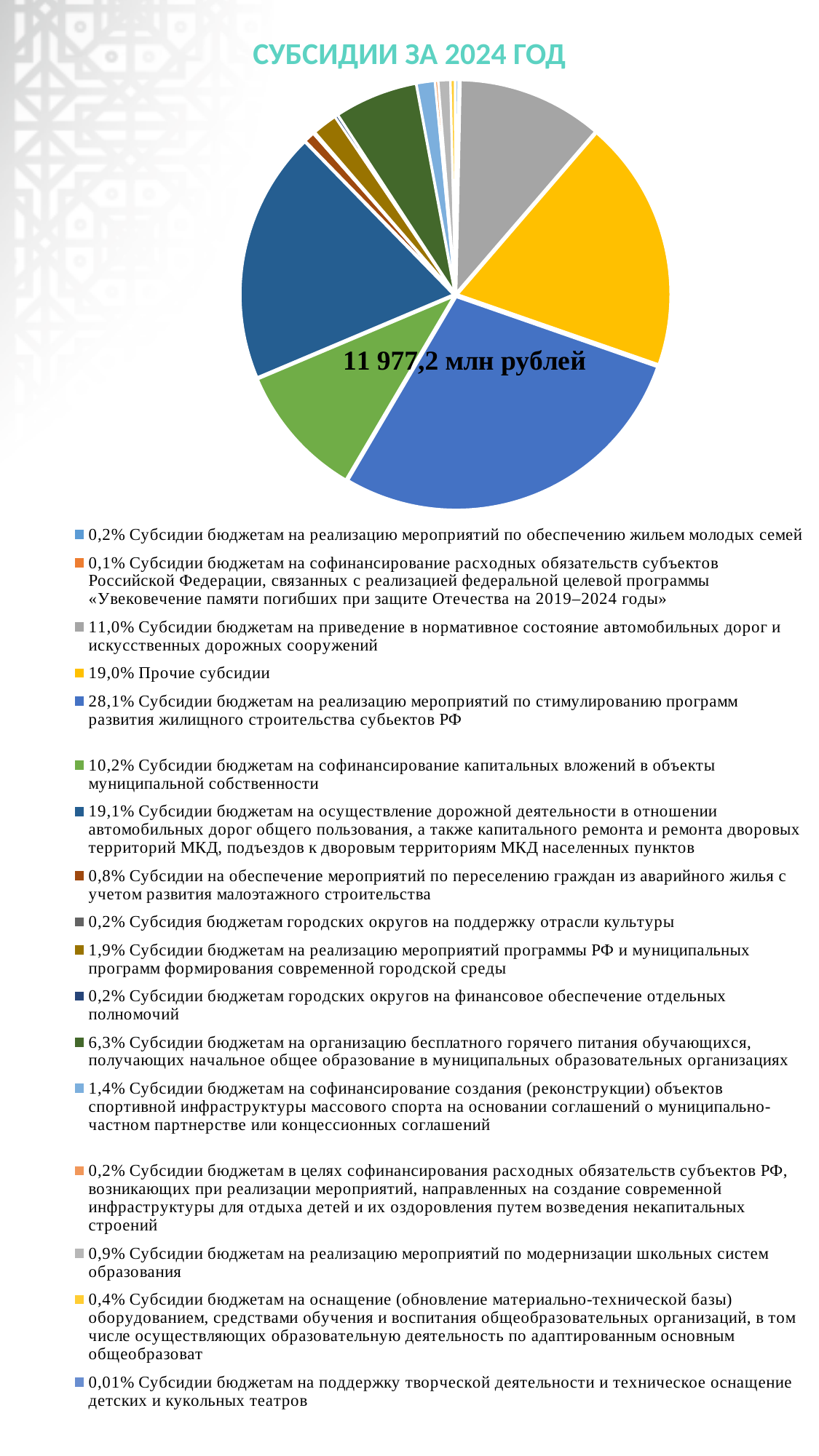
What total amount is printed in the centre of the pie chart? 11 977,2 млн рублей Which category has the largest share of the pie? Субсидии бюджетам на реализацию мероприятий по стимулированию программ развития жилищного строительства субъектов РФ (28,1%) Which category has the smallest share of the pie? Субсидии бюджетам на поддержку творческой деятельности и техническое оснащение детских и кукольных театров (0,01%) What share of the pie is 'Субсидии бюджетам на реализацию мероприятий по модернизации школьных систем образования'? 0,9% Which is larger: the share for 'Субсидии бюджетам на организацию бесплатного горячего питания обучающихся...' or the share for 'Субсидии бюджетам на реализацию мероприятий программы РФ и муниципальных программ формирования современной городской среды'? Субсидии бюджетам на организацию бесплатного горячего питания обучающихся (6,3%) What kind of chart is shown on the slide? pie chart What is the title of the chart? СУБСИДИИ ЗА 2024 ГОД What share of the pie is 'Субсидии бюджетам на приведение в нормативное состояние автомобильных дорог и искусственных дорожных сооружений'? 11,0% What share of the pie is 'Субсидии бюджетам на софинансирование капитальных вложений в объекты муниципальной собственности'? 10,2% How many categories does the legend of the pie chart list? 17 What is the difference in percentage points between the share for housing construction stimulation subsidies (28,1%) and the share for road activity subsidies (19,1%)? 9,0 percentage points